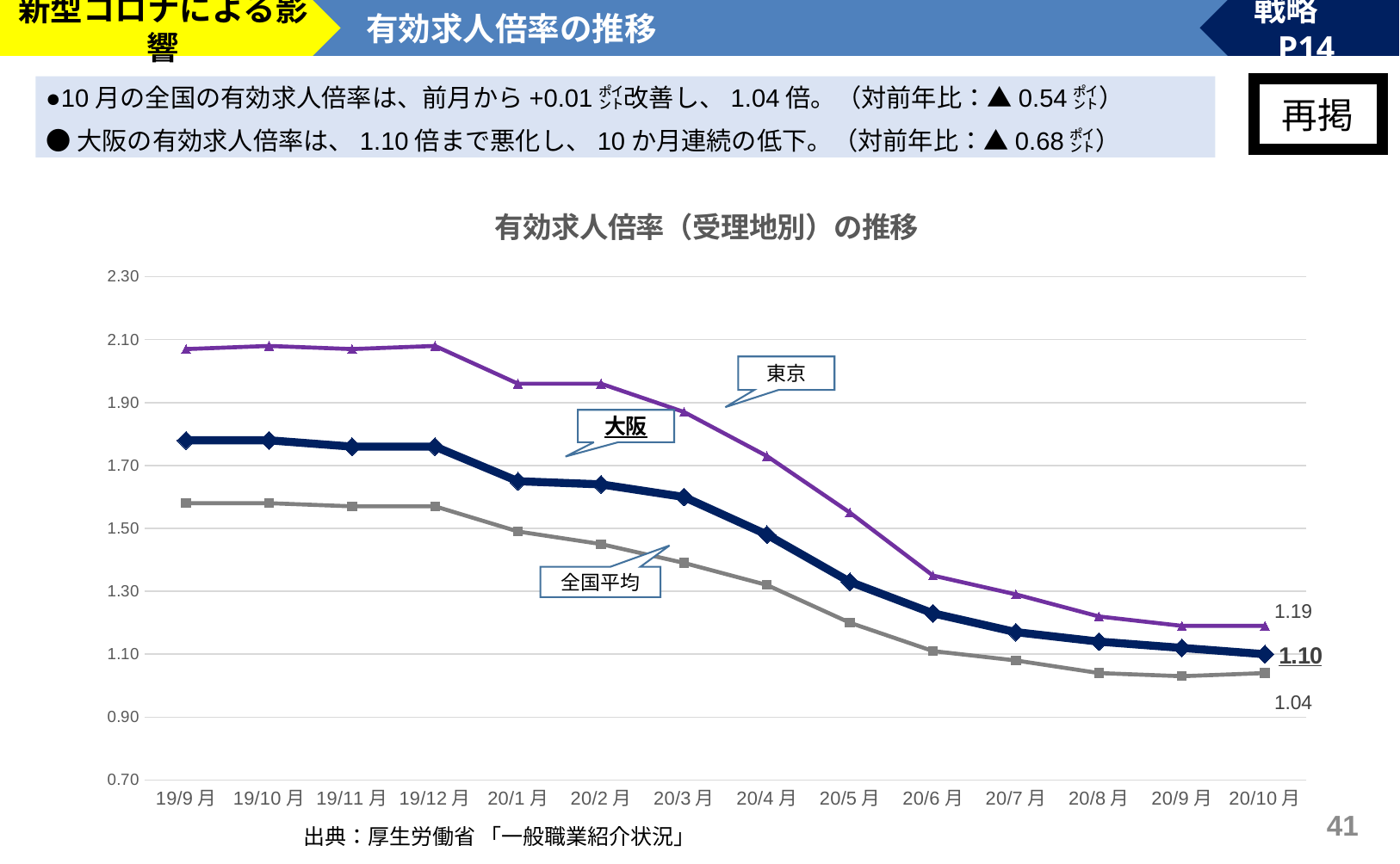
Which is larger at 20/3月, the value for 東京 or the value for 全国平均? 東京 At 20/10月, what is the difference between the 東京 value and the 大阪 value? 0.09 Is the value for 東京 at 19/9月 greater or less than 1.90? greater How many series are plotted in the chart? 3 What kind of chart is shown on the slide? line chart What is the value for 東京 at 20/10月? 1.19 Which series has the lowest value at 20/10月? 全国平均 How many months are shown along the x axis of the chart? 14 What is the title of the chart? 有効求人倍率（受理地別）の推移 What is the value for 全国平均 at 20/10月? 1.04 What is the value for 大阪 at 20/10月? 1.10 Does the 大阪 series rise or fall from 19/9月 to 20/10月? fall